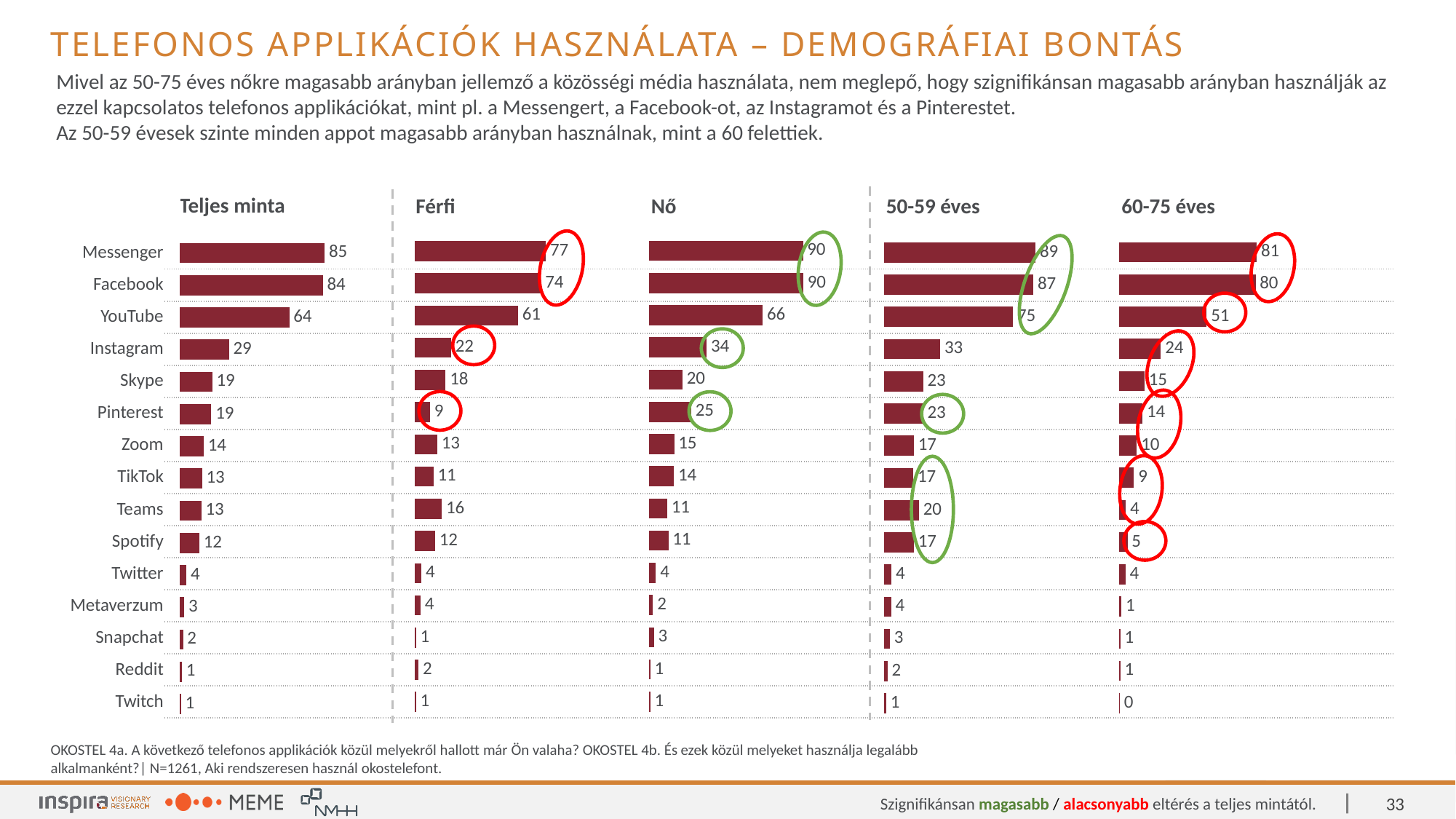
In the '60-75 éves' chart, what is the value for YouTube? 51 In the 'Férfi' chart, what is the value for Pinterest? 9 What kind of chart is used for the 'Teljes minta' data? Bar chart In the '60-75 éves' chart, which category has the lowest value? Twitch In the 'Nő' chart, what is the value for Instagram? 34 In the 'Teljes minta' chart, what is the value for Messenger? 85 In the 'Nő' chart, what is the difference between the values for YouTube and Instagram? 32 How many separate bar charts are shown on the slide? 5 In the '50-59 éves' chart, which category has the highest value? Messenger In the 'Férfi' chart, which is larger: the value for Teams or the value for TikTok? Teams How many categories are shown in the 'Teljes minta' chart? 15 In the '50-59 éves' chart, what is the difference between the values for Facebook and YouTube? 12